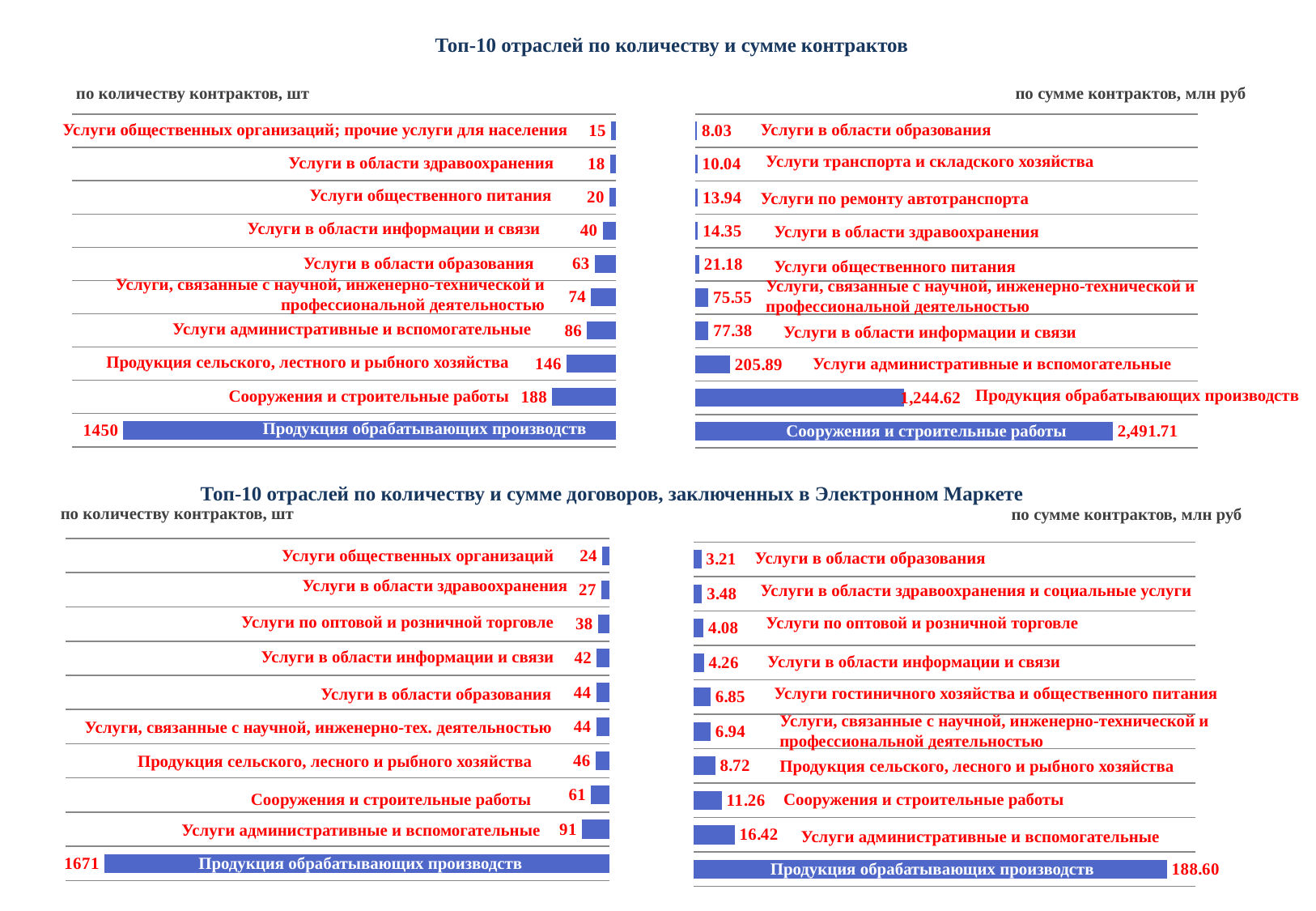
In the bottom-left chart (Электронный Маркет, по количеству контрактов, шт), what is the difference between Продукция обрабатывающих производств and Услуги административные и вспомогательные? 1580 In the top-right chart (по сумме контрактов, млн руб), which is larger: Услуги в области информации и связи or Услуги, связанные с научной, инженерно-технической и профессиональной деятельностью? Услуги в области информации и связи In the top-left chart (Топ-10 отраслей по количеству контрактов, шт), what is the value for Продукция обрабатывающих производств? 1450 In the bottom-left chart (Электронный Маркет, по количеству контрактов, шт), what is the value for Услуги административные и вспомогательные? 91 What type of chart is used in the top-left chart (по количеству контрактов, шт)? Bar chart In the top-left chart (по количеству контрактов, шт), what is the difference between Сооружения и строительные работы and Продукция сельского, лестного и рыбного хозяйства? 42 In the bottom-left chart (Электронный Маркет, по количеству контрактов, шт), how many categories are shown? 10 In the bottom-right chart (Электронный Маркет, по сумме контрактов, млн руб), what is the value for Продукция обрабатывающих производств? 188.60 In the bottom-right chart (Электронный Маркет, по сумме контрактов, млн руб), which category has the lowest value? Услуги в области образования In the top-right chart (по сумме контрактов, млн руб), which category has the highest value? Сооружения и строительные работы In the top-left chart (по количеству контрактов, шт), which category has the lowest value? Услуги общественных организаций; прочие услуги для населения In the top-right chart (по сумме контрактов, млн руб), what is the value for Сооружения и строительные работы? 2,491.71